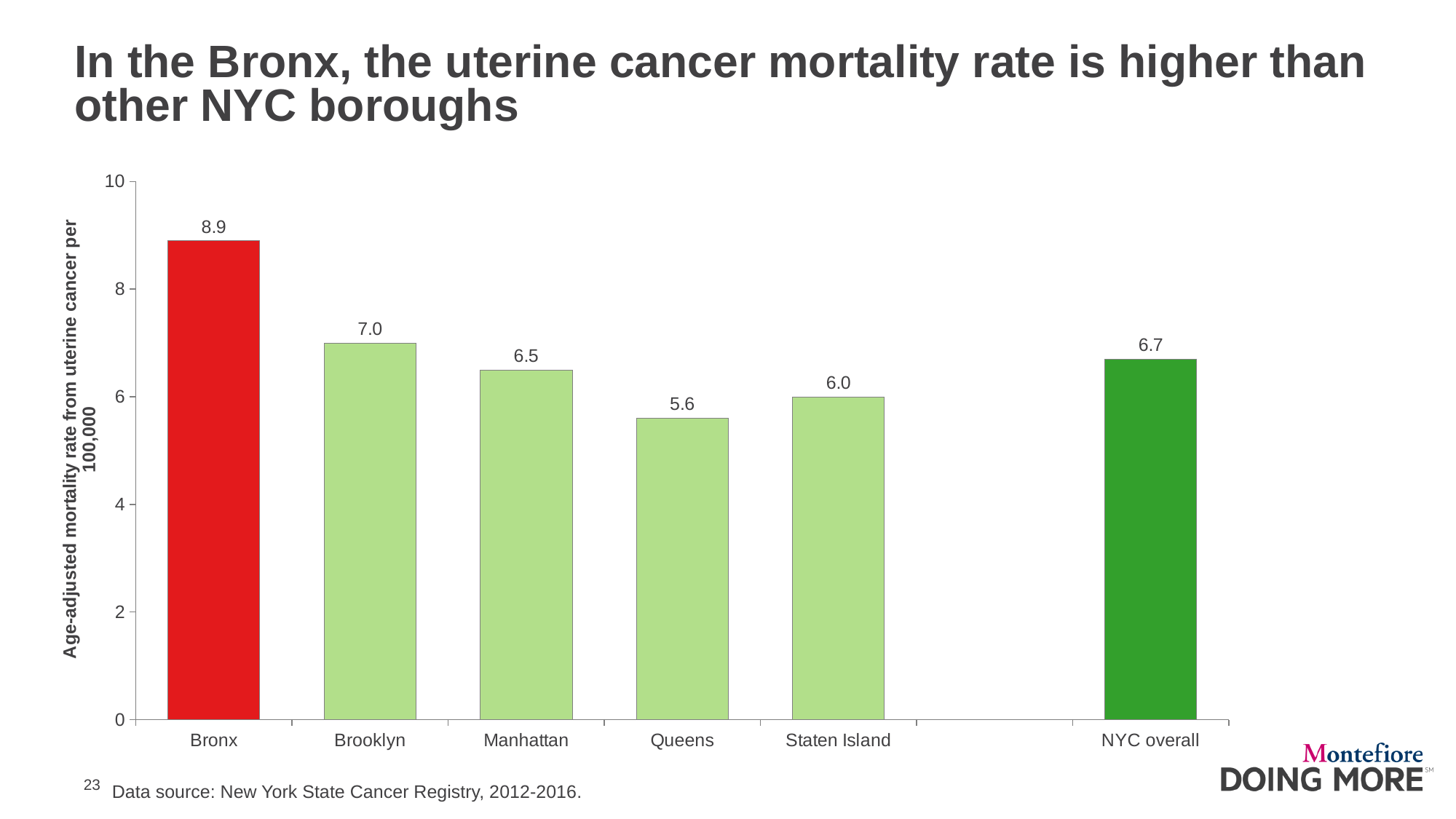
Which borough has the highest uterine cancer mortality rate? Bronx Is the value for Brooklyn greater or less than 6? greater What is the value shown for NYC overall? 6.7 What is the age-adjusted uterine cancer mortality rate for the Bronx? 8.9 What type of chart is shown on the slide? Bar chart What is the difference between the Bronx rate and the NYC overall rate? 2.2 Which has a higher uterine cancer mortality rate, Manhattan or Staten Island? Manhattan What colour is the bar for the Bronx? Red What is the uterine cancer mortality rate shown for Queens? 5.6 How many bars are shown in the chart? 6 Which borough has the lowest uterine cancer mortality rate? Queens What is the difference between the Brooklyn and Staten Island rates? 1.0